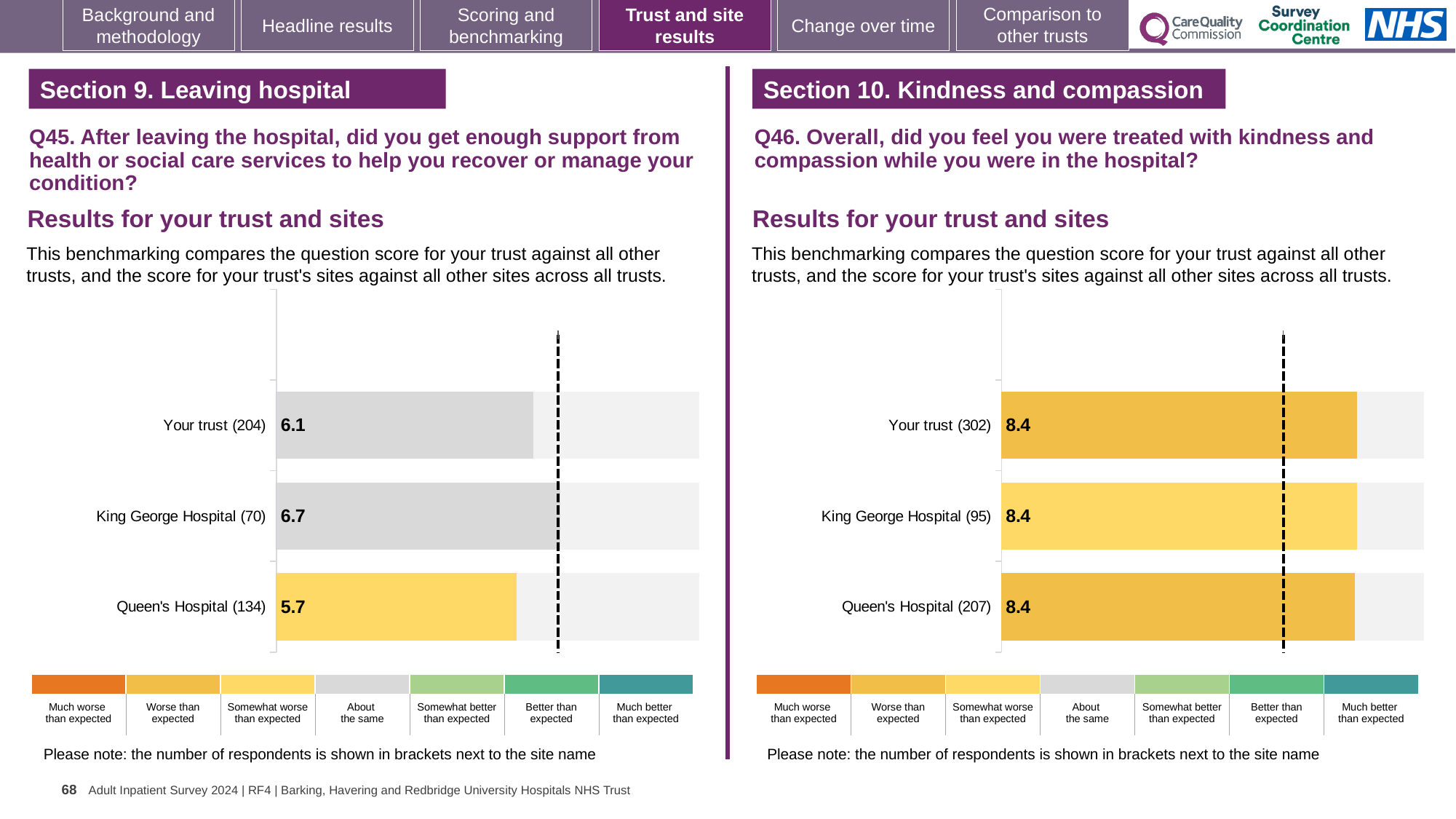
On the Q46 chart (right), what is the score for Queen's Hospital? 8.4 On the Q45 chart (left), which site or trust has the lowest score? Queen's Hospital On the Q45 chart (left), which has the larger score, Your trust or Queen's Hospital? Your trust On the Q45 chart (left), how many respondents are shown in brackets for Queen's Hospital? 134 On the Q45 chart (left), what is the score for King George Hospital? 6.7 On the Q45 chart (left), what is the score for Queen's Hospital? 5.7 What kind of chart is the Q45 chart (left)? Bar chart On the Q45 chart (left), what is the difference between the King George Hospital score and the Queen's Hospital score? 1.0 On the Q45 chart (left), what is the score for Your trust? 6.1 On the Q46 chart (right), what is the score for Your trust? 8.4 On the Q46 chart (right), how many bars are plotted? 3 On the Q45 chart (left), which site or trust has the highest score? King George Hospital